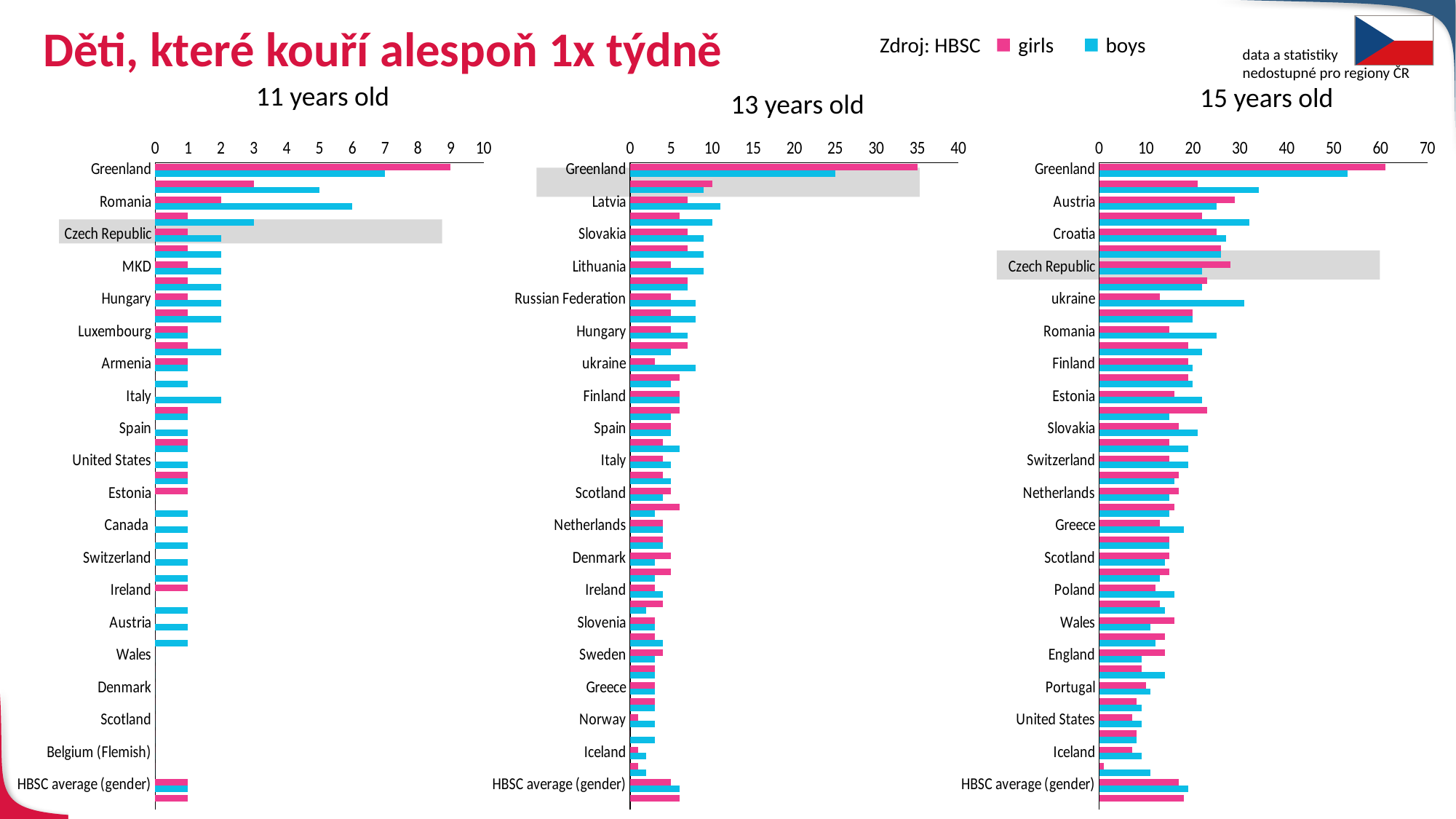
Which colour represents boys in the legend? blue In the "11 years old" chart, which country has the highest value for girls? Greenland In the "15 years old" chart, is the value for HBSC average (gender) girls greater or less than 30? less In the "13 years old" chart, is the value for Greenland boys greater or less than 20? greater How many series does the legend list? 2 In the "13 years old" chart, which is larger for Greenland, the girls value or the boys value? girls What kind of chart is the "11 years old" chart? bar chart In the "13 years old" chart, which country has the highest value for girls? Greenland In the "11 years old" chart, is the value for Greenland girls greater or less than 5? greater In the "15 years old" chart, which is larger for Greenland, the girls value or the boys value? girls In the "15 years old" chart, which country has the highest value for boys? Greenland